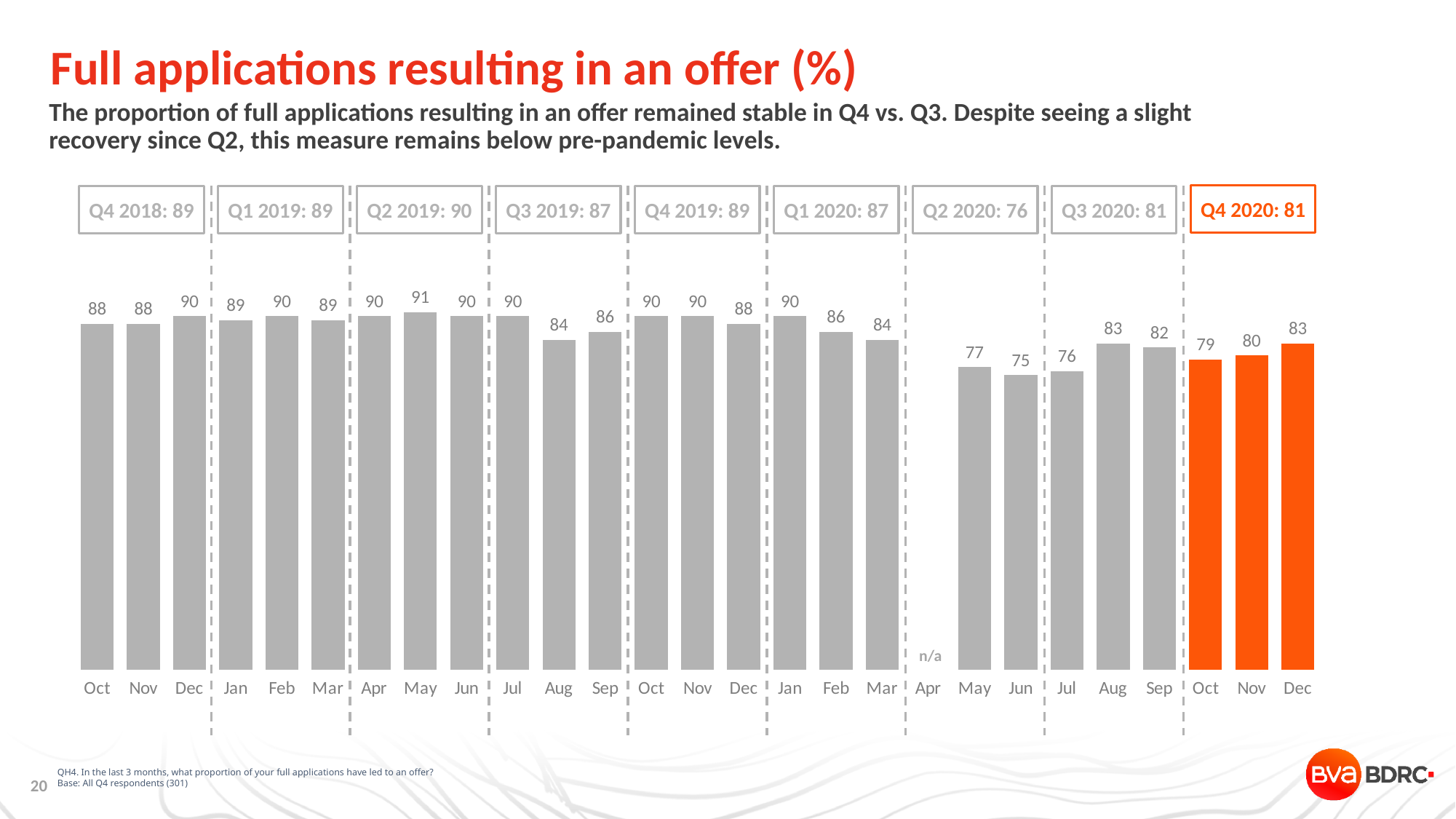
What is the value for Jun in Q2 2020? 75 Which bars are coloured orange rather than grey? Oct, Nov, Dec of Q4 2020 Which month has the highest value in the chart? May (Q2 2019) What is the value for Dec in Q4 2020? 83 What is the difference between the Dec value in Q4 2020 and the Oct value in Q4 2020? 4 Which month is marked as n/a with no bar? Apr (Q2 2020) What is the quarterly figure shown in the box for Q2 2020? 76 How many month labels are shown along the x axis? 27 What is the value for May in Q2 2019? 91 Which is larger, the Aug value in Q3 2020 or the Sep value in Q3 2020? Aug Which month has the lowest value in the chart? Jun (Q2 2020) What kind of chart is shown on the slide? bar chart